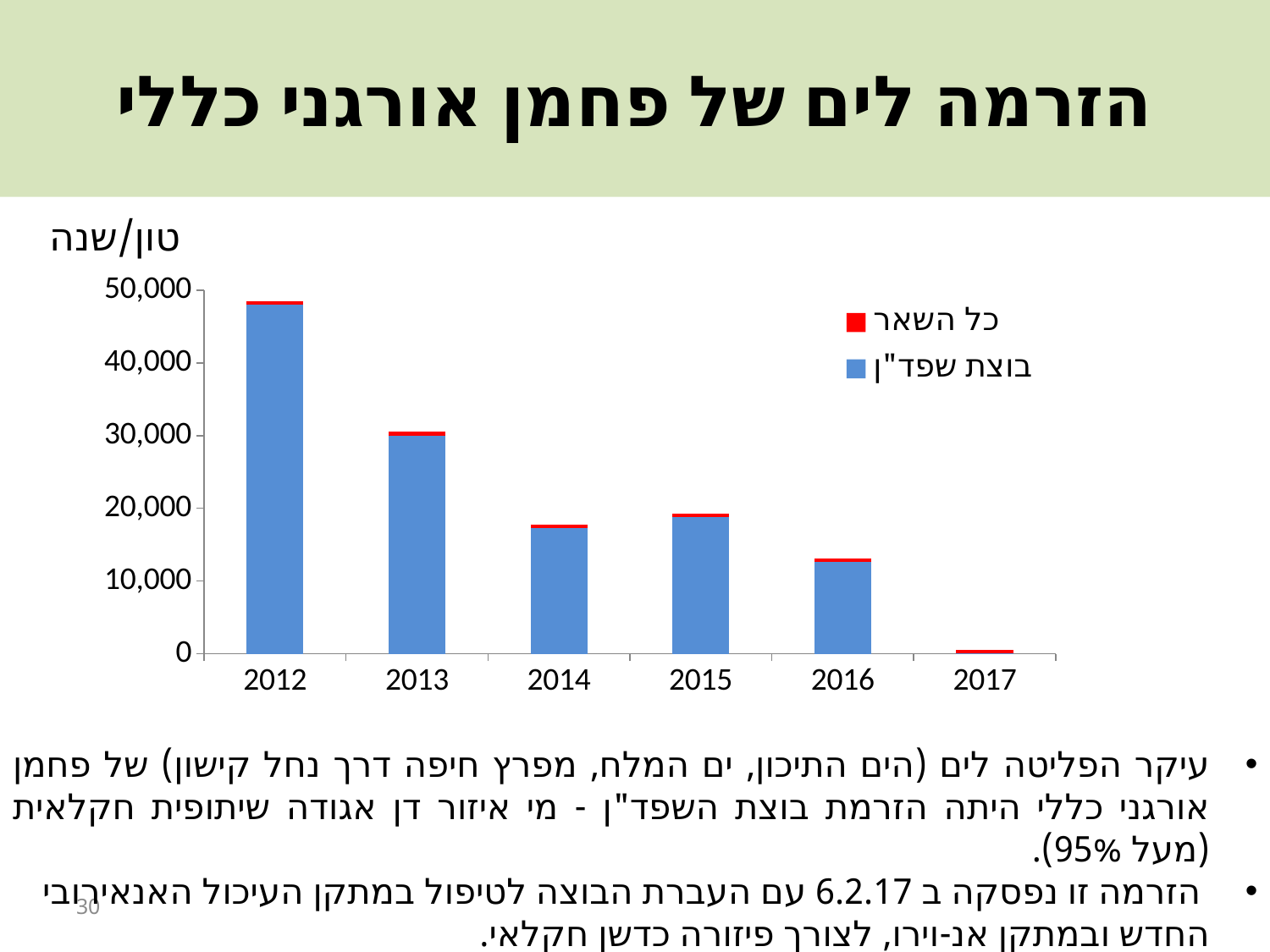
Is the total value for 2014 greater or less than 20,000? less Which year has the highest total bar in the chart? 2012 How many series does the chart legend list? 2 What unit label is shown above the y axis of the chart? טון/שנה Is the total value for 2016 greater or less than 10,000? greater Which year has a larger total bar, 2013 or 2016? 2013 What kind of chart is shown on the slide? bar chart Do the bar values generally rise or fall from 2012 to 2017? fall Which year has the lowest total bar in the chart? 2017 Is the total value for 2012 greater or less than 40,000? greater How many years are shown on the x axis of the chart? 6 What is the title of the chart slide? הזרמה לים של פחמן אורגני כללי